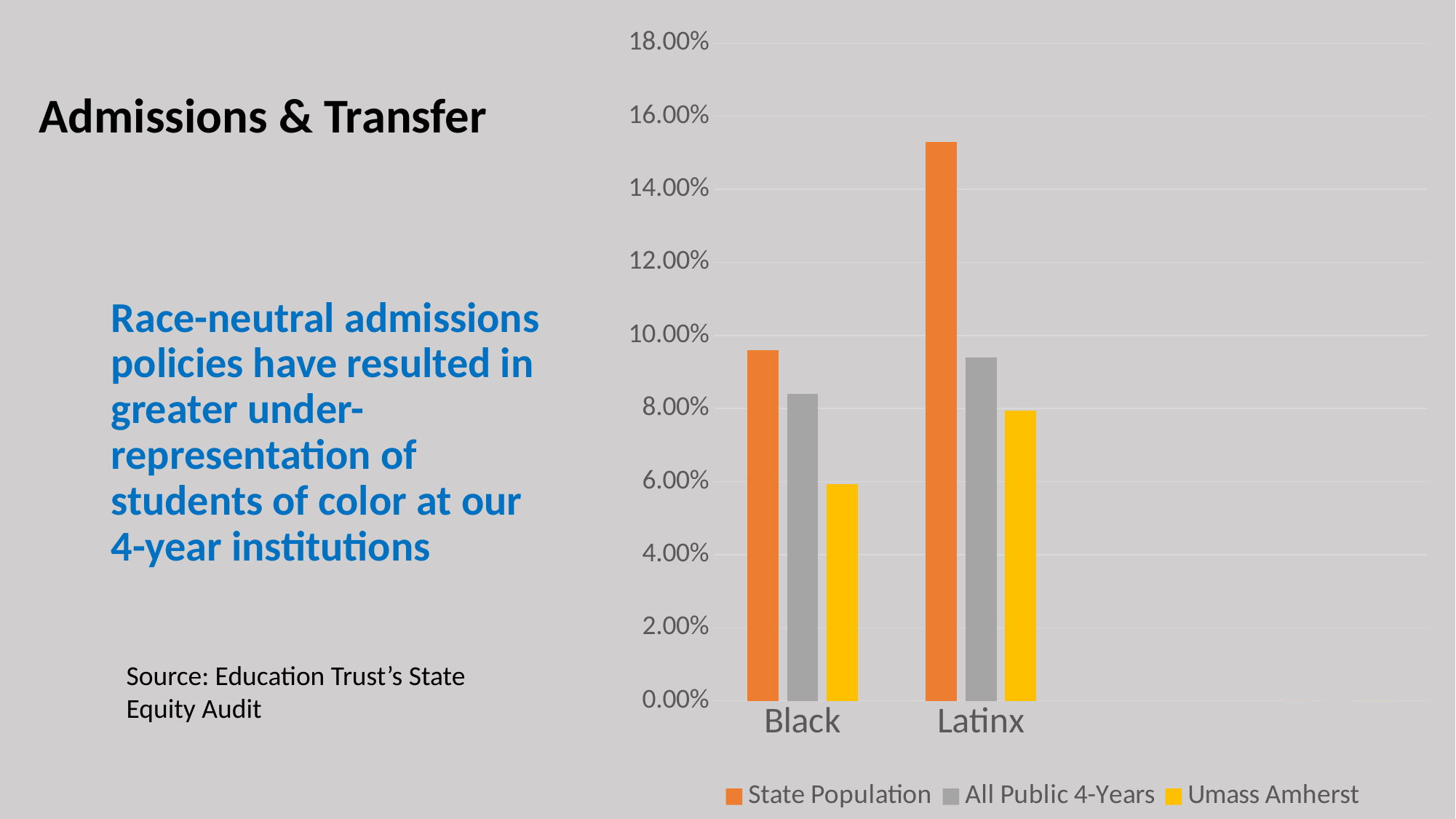
How many series does the chart's legend list? 3 Which is larger, the State Population value for Black or the State Population value for Latinx? Latinx Is the State Population value for Latinx greater or less than 14.00%? greater For the Black category, which is larger, the All Public 4-Years value or the Umass Amherst value? All Public 4-Years Is the Umass Amherst value for Black greater or less than 8.00%? less Which category and series has the tallest bar in the chart? Latinx, State Population What kind of chart is shown on the slide? bar chart What colour represents the State Population series in the chart? orange Is the All Public 4-Years value for Latinx greater or less than 10.00%? less Which category and series has the shortest bar in the chart? Black, Umass Amherst How many categories are shown on the x axis of the chart? 2